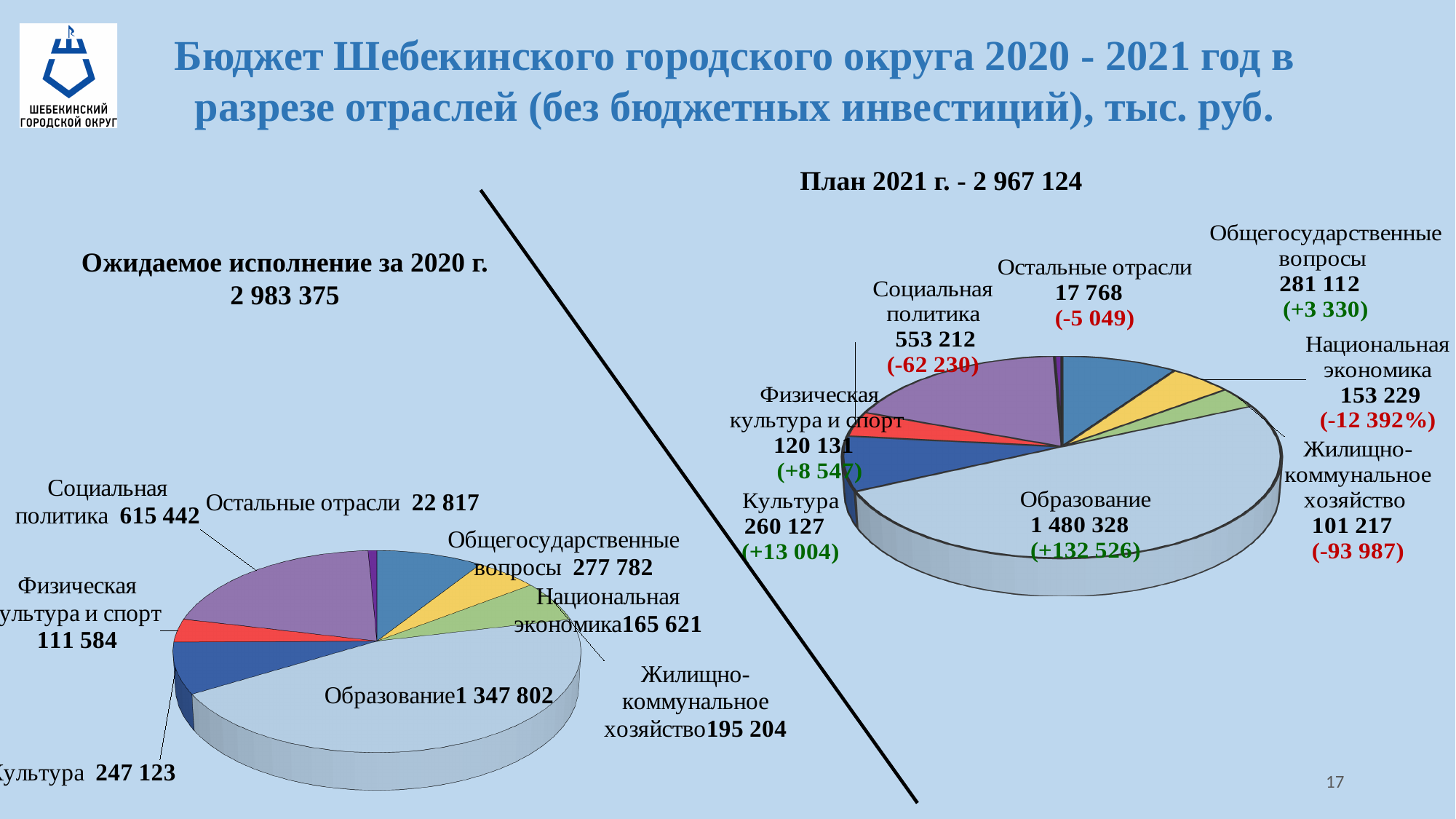
In the right chart (План 2021 г.), which category has the smallest value? Остальные отрасли What is the difference between the value for Образование in the right chart (План 2021 г.) and in the left chart (Ожидаемое исполнение за 2020 г.)? 132 526 In the left chart (Ожидаемое исполнение за 2020 г.), which category has the largest value? Образование How many categories are shown in the left chart (Ожидаемое исполнение за 2020 г.)? 8 What total is stated for the right chart, План 2021 г.? 2 967 124 In the left chart (Ожидаемое исполнение за 2020 г.), what is the value for Образование? 1 347 802 In the left chart (Ожидаемое исполнение за 2020 г.), what is the difference between Социальная политика and Культура? 368 319 In the right chart (План 2021 г.), which is larger: Общегосударственные вопросы or Национальная экономика? Общегосударственные вопросы In the right chart (План 2021 г.), what is the value for Жилищно-коммунальное хозяйство? 101 217 In the right chart (План 2021 г.), what is the value for Культура? 260 127 In the right chart (План 2021 г.), what change is shown in parentheses for Социальная политика? -62 230 What type of chart is used on the left side of the slide for 'Ожидаемое исполнение за 2020 г.'? Pie chart